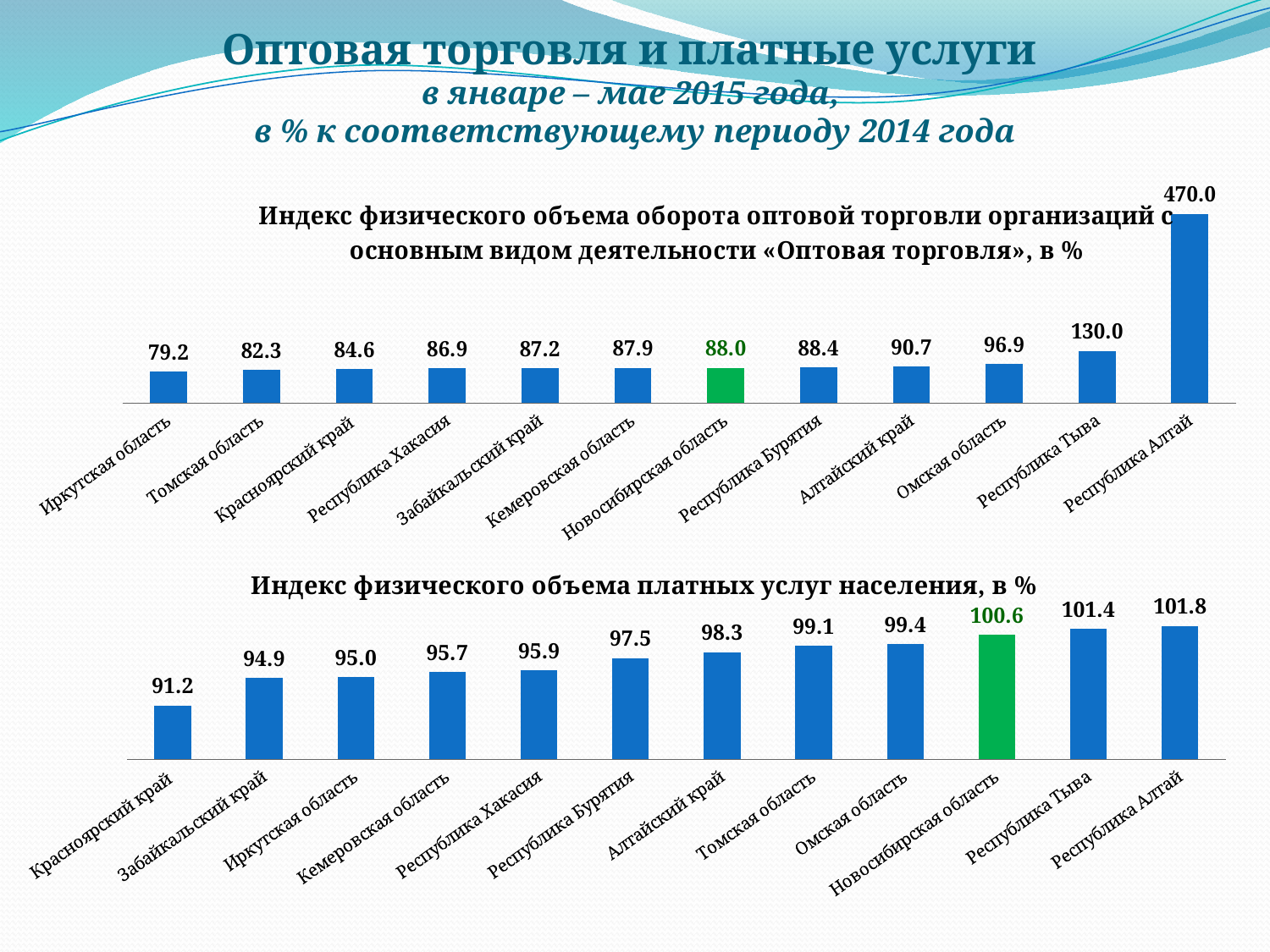
What type of chart is the bottom chart (paid services index)? bar chart In the bottom chart (paid services index), what is the difference between Республика Алтай and Красноярский край? 10.6 In the top chart (wholesale trade turnover index), what is the difference between Республика Алтай and Республика Тыва? 340.0 In the bottom chart (paid services index), which is larger: Республика Тыва or Алтайский край? Республика Тыва In the top chart (wholesale trade turnover index), what is the value for Новосибирская область? 88.0 In the top chart (wholesale trade turnover index), which bar is coloured green? Новосибирская область In the top chart (wholesale trade turnover index), how many regions are shown? 12 In the bottom chart (paid services index), do the values rise or fall from left to right? rise In the top chart (wholesale trade turnover index), which region has the highest value? Республика Алтай In the bottom chart (paid services index), which region has the lowest value? Красноярский край In the top chart (wholesale trade turnover index), which region has the lowest value? Иркутская область In the bottom chart (paid services index), what is the value for Омская область? 99.4